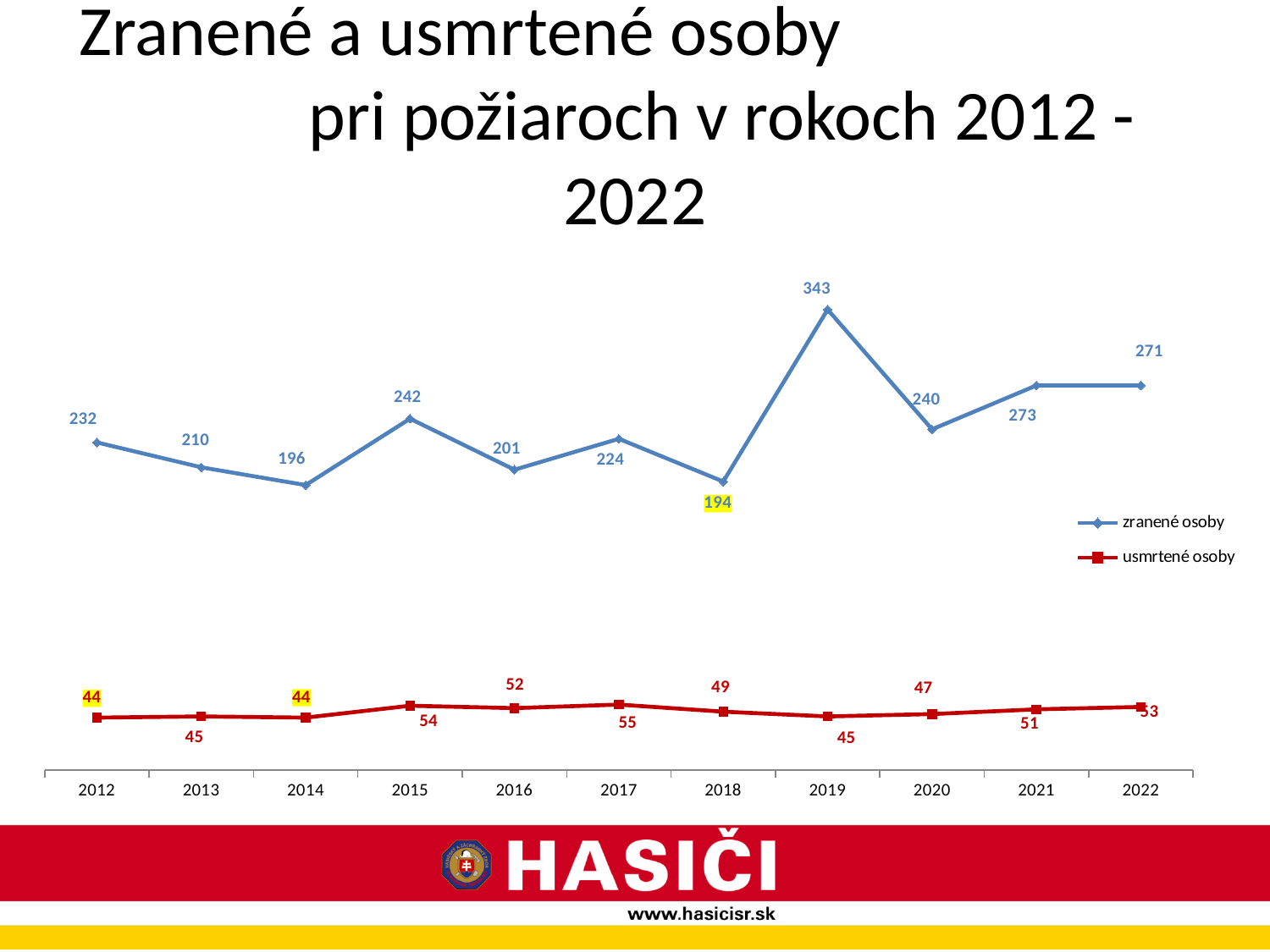
What kind of chart is shown on the slide? line chart What is the value for zranené osoby in 2019? 343 In which year is the value for usmrtené osoby highest? 2017 What is the value for usmrtené osoby in 2017? 55 How many years are shown on the x axis? 11 In which year is the value for zranené osoby lowest? 2018 Which is larger, the zranené osoby value for 2015 or for 2017? 2015 What is the difference between the zranené osoby values for 2019 and 2018? 149 What is the value for zranené osoby in 2018? 194 What is the difference between the usmrtené osoby values for 2022 and 2012? 9 How many series does the legend list? 2 In which year is the value for zranené osoby highest? 2019